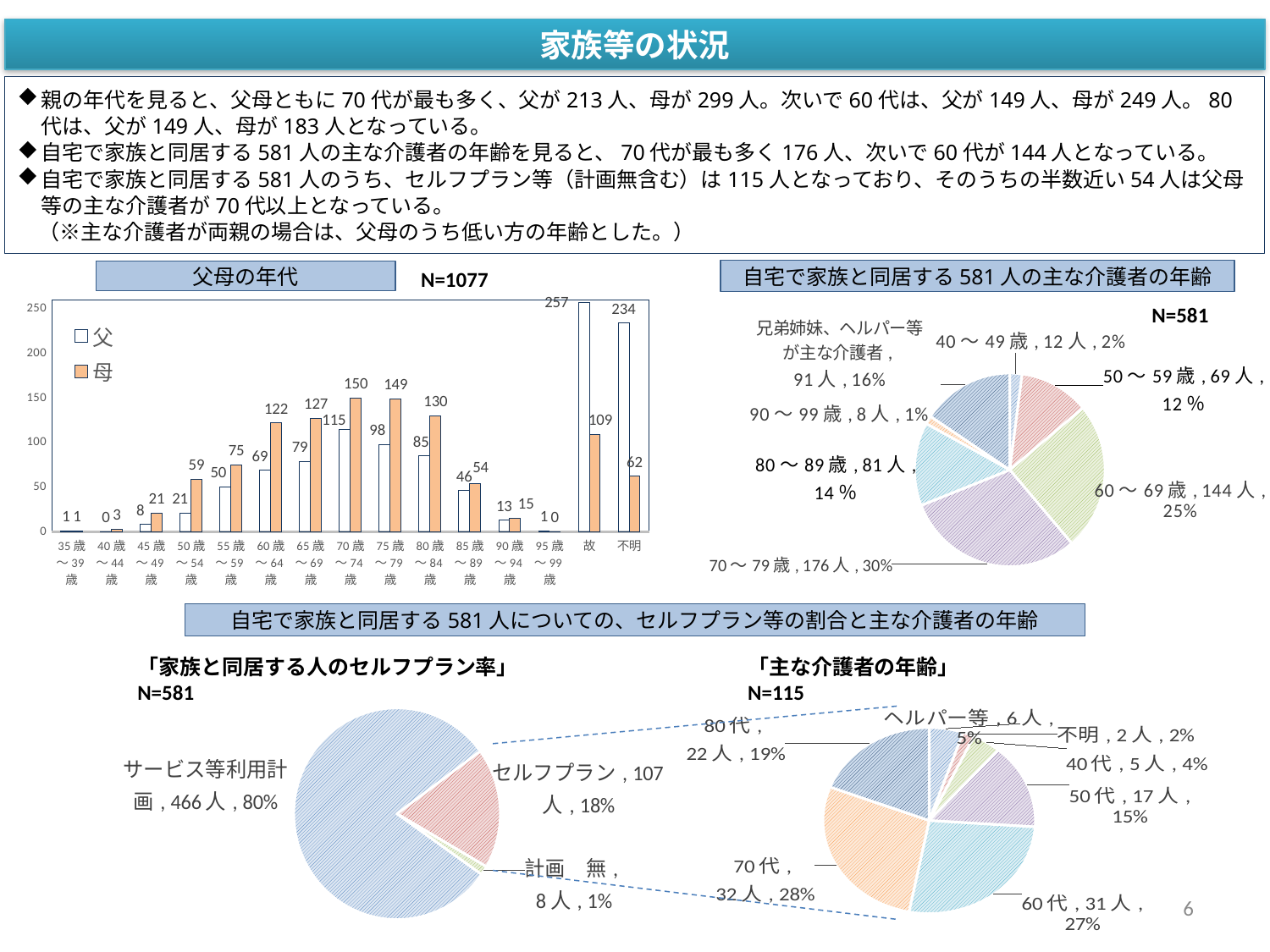
「自宅で家族と同居する581人の主な介護者の年齢」の円グラフで、最も割合が大きい区分はどれですか？ 70～79歳 「父母の年代」のグラフで、父の系列で最も値が大きいカテゴリはどれですか？ 故 「主な介護者の年齢」（N=115）の円グラフには区分がいくつありますか？ 7 「自宅で家族と同居する581人の主な介護者の年齢」の円グラフで、60～69歳の人数と割合はいくつですか？ 144人, 25% 「父母の年代」のグラフで、70歳～74歳の母の人数はいくつですか？ 150 「父母の年代」のグラフの凡例には系列がいくつありますか？ 2 「父母の年代」のグラフで、60歳～64歳の父の人数はいくつですか？ 69 「父母の年代」のグラフで、80歳～84歳では父と母のどちらの人数が多いですか？ 母 「家族と同居する人のセルフプラン率」の円グラフで、セルフプランの割合は何%ですか？ 18% 「父母の年代」のグラフで、75歳～79歳の母と父の人数の差はいくつですか？ 51 「父母の年代」のグラフはどの種類のグラフですか？ 棒グラフ 「主な介護者の年齢」（N=115）の円グラフで、60代の人数はいくつですか？ 31人